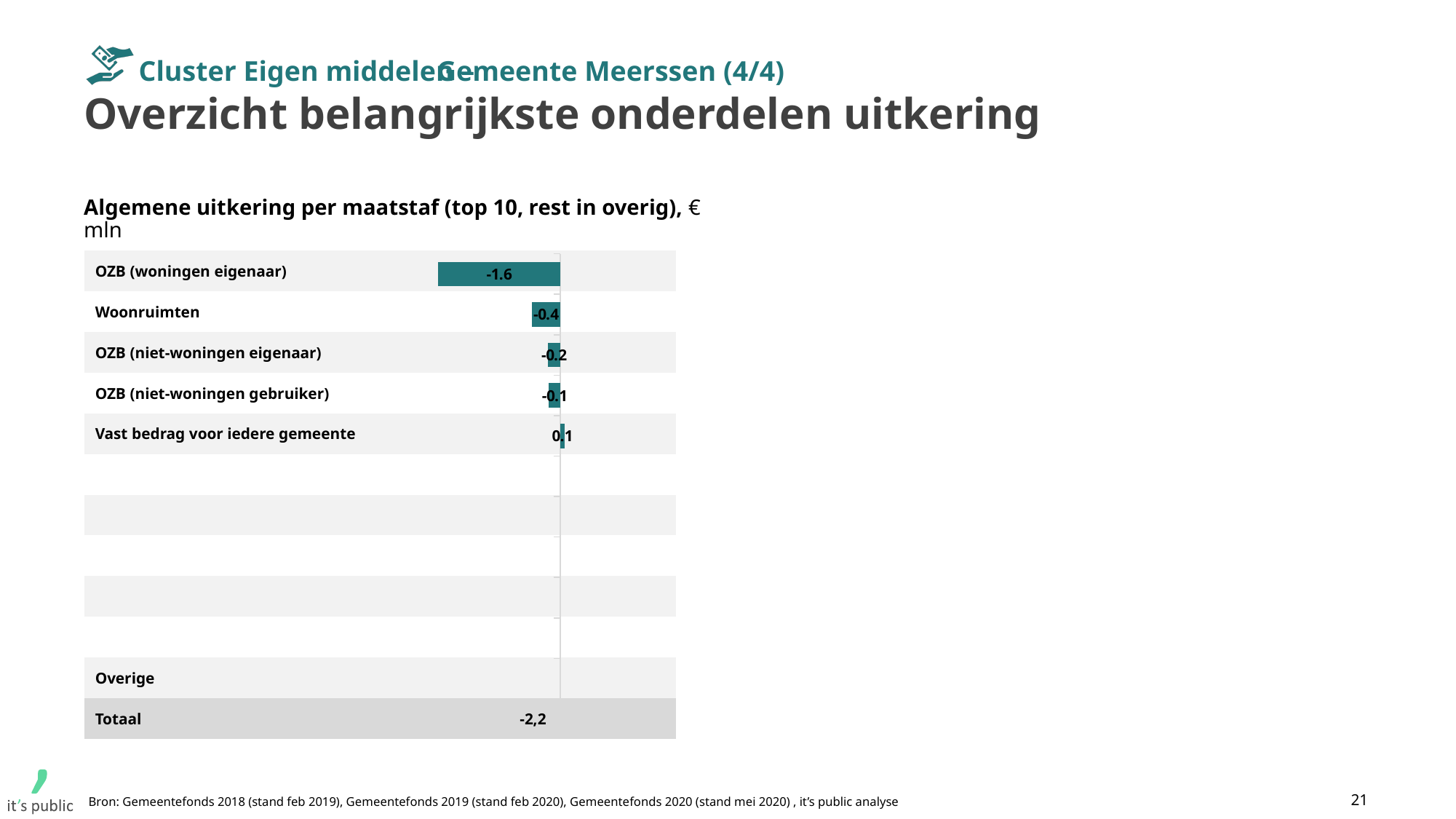
What is the value for OZB (niet-woningen gebruiker)? -0.1 What kind of chart is shown on the slide? Bar chart What is the value for Vast bedrag voor iedere gemeente? 0.1 What is the difference between the values for OZB (woningen eigenaar) and Woonruimten? 1.2 What is the value for OZB (woningen eigenaar)? -1.6 Which category has the highest value? Vast bedrag voor iedere gemeente What is the value for Woonruimten? -0.4 How many categories have a bar with a printed value label? 5 Which has the larger decrease, Woonruimten or OZB (niet-woningen eigenaar)? Woonruimten What is the value for OZB (niet-woningen eigenaar)? -0.2 Which category has the lowest (most negative) value? OZB (woningen eigenaar) What value is shown for the Totaal row? -2,2